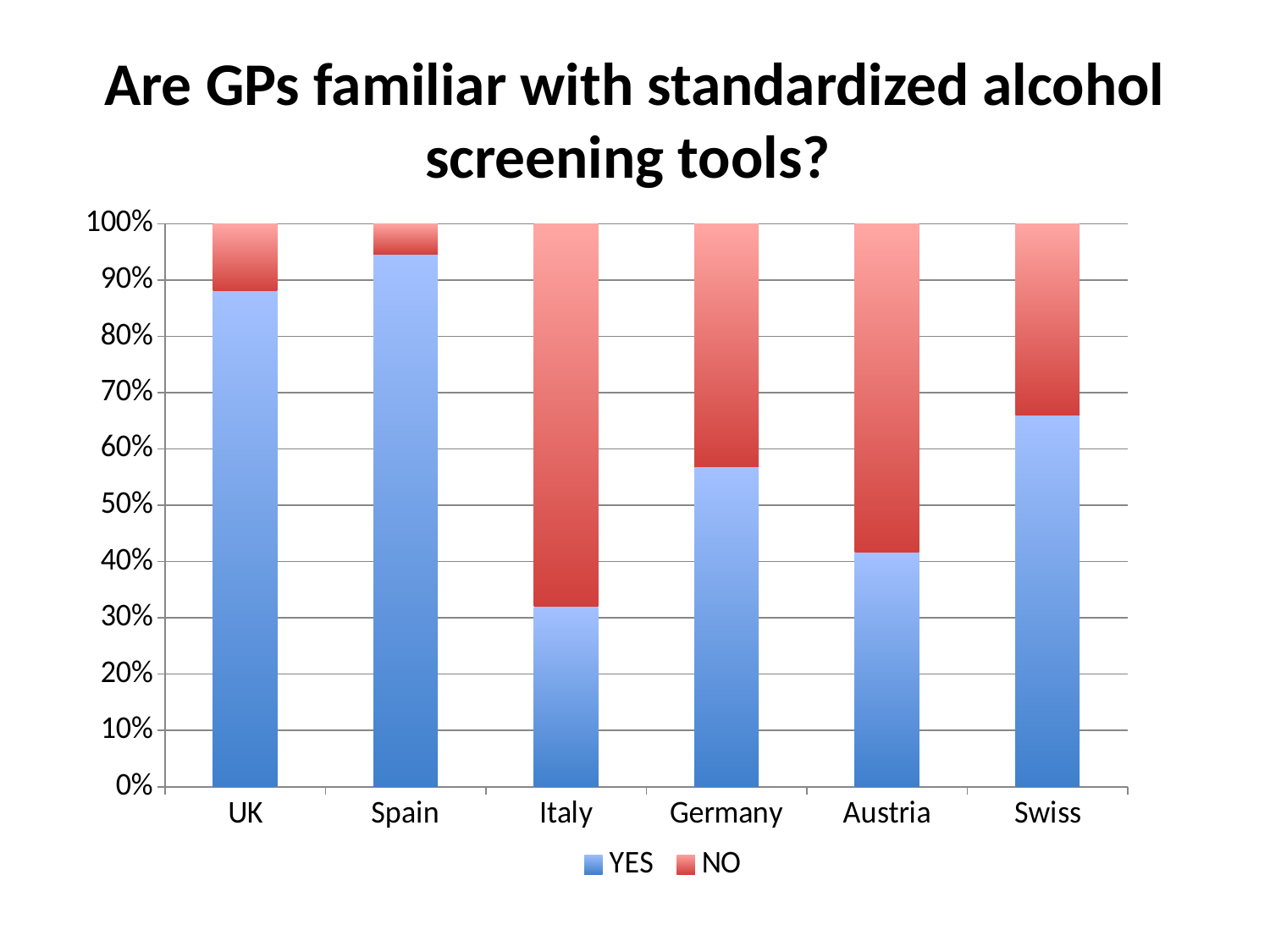
How many countries are shown on the x axis? 6 What is the total of the stacked bar for Germany? 100% Which country has the highest YES share? Spain Is the YES value for UK greater or less than 80%? greater Which country has the lowest YES share? Italy Is the YES value for Austria greater or less than 50%? less Which has a larger YES share, Germany or Swiss? Swiss Which colour represents the NO series in the legend? Red Which country has the largest NO share? Italy What kind of chart is shown on the slide? Stacked bar chart How many series does the legend list? 2 Is the YES value for Italy greater or less than 40%? less